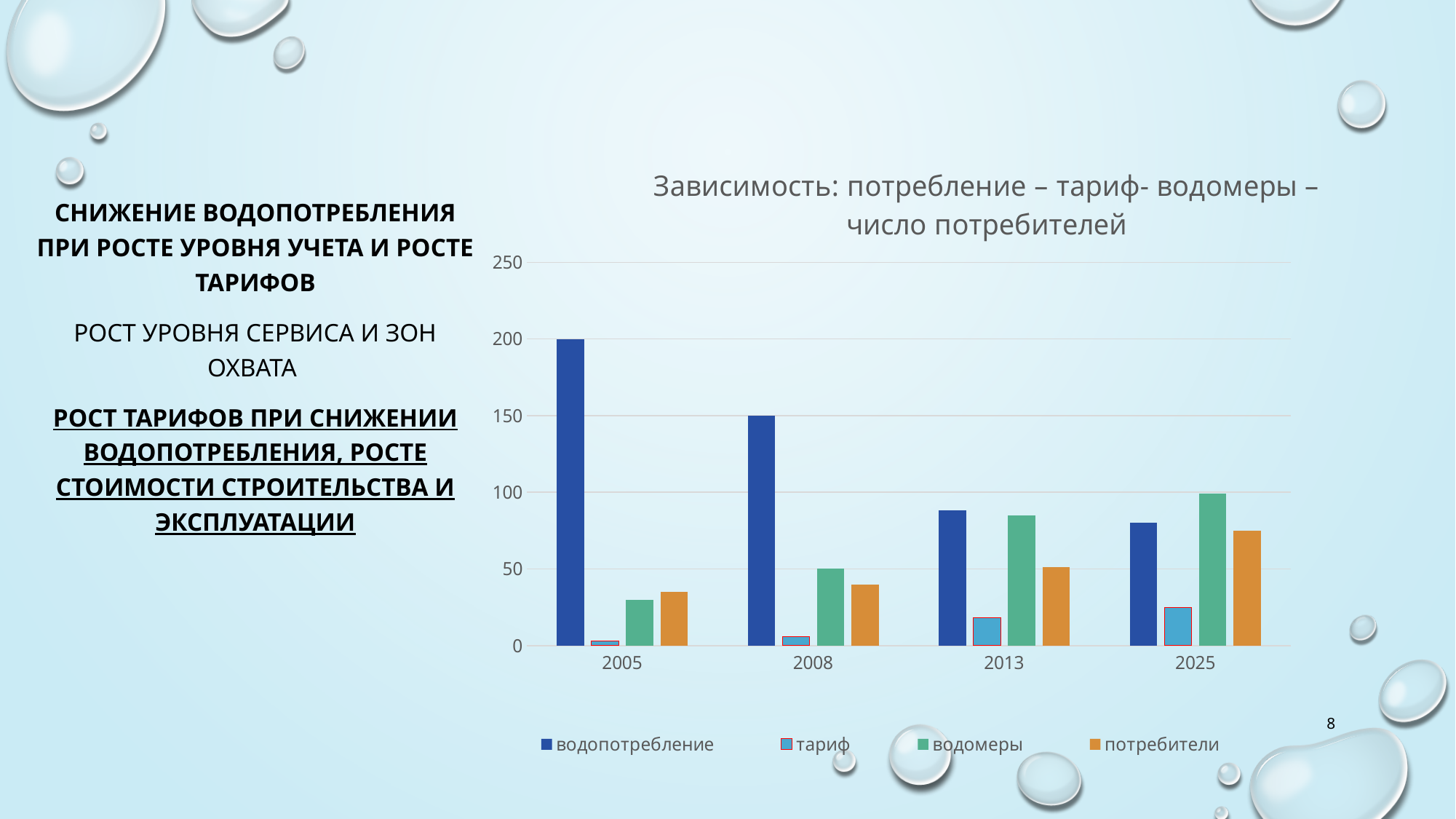
In which year is тариф lowest? 2005 How many year categories are shown on the x axis of the chart? 4 How many series does the chart legend list? 4 What is the value of водопотребление in 2008? 150 What is the value of водопотребление in 2005? 200 What kind of chart is shown on the slide? bar chart What is the difference between водопотребление in 2005 and in 2008? 50 Does водомеры rise or fall from 2005 to 2025? rise In 2013, which is larger: водомеры or потребители? водомеры Is the value for потребители in 2025 greater or less than 100? less Does водопотребление rise or fall from 2005 to 2025? fall In which year is водопотребление highest? 2005